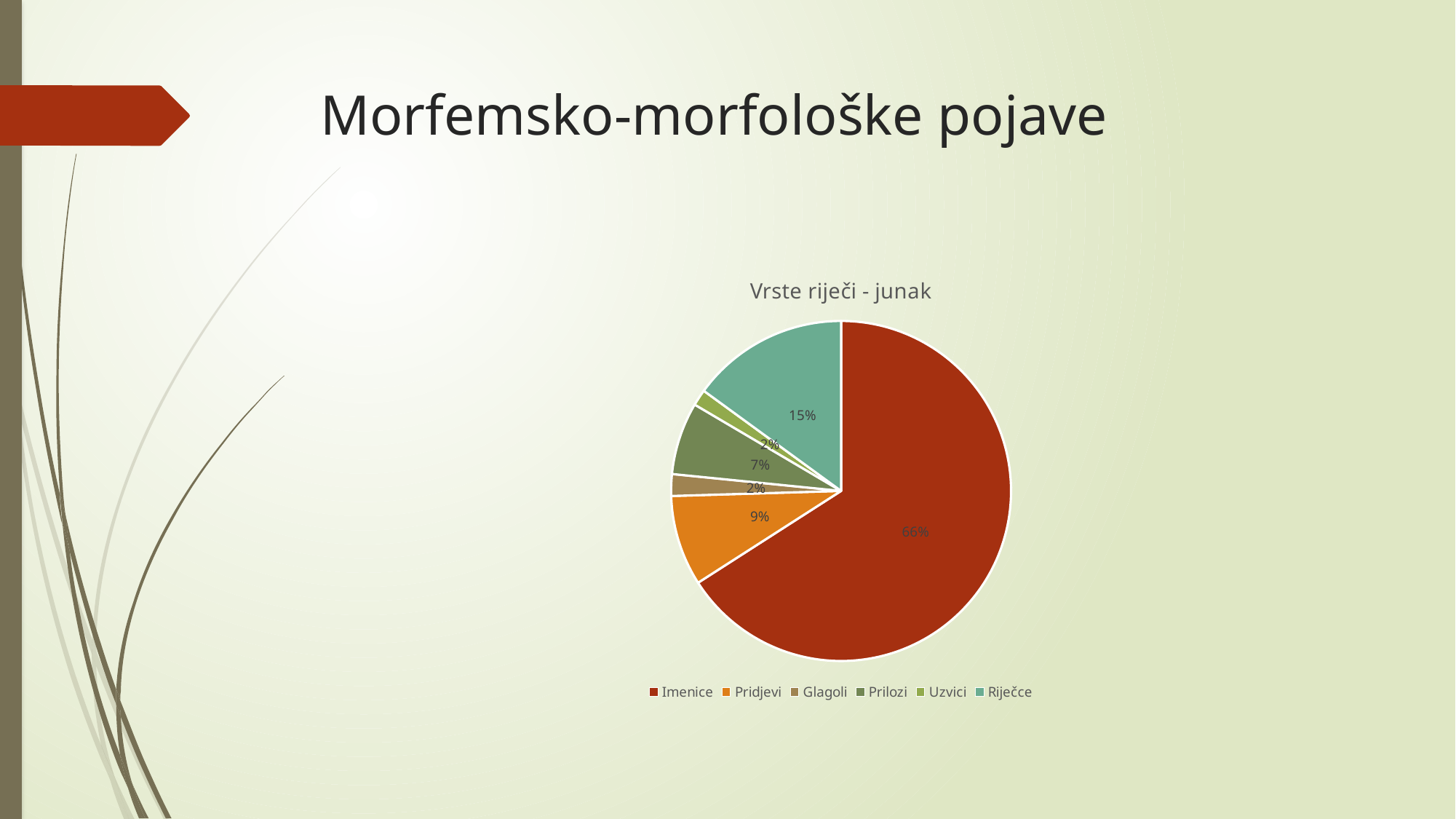
What share of the pie does Riječce take? 15% What is the title of the chart? Vrste riječi - junak Which is larger, the slice for Riječce or the slice for Pridjevi? Riječce What share of the pie does Imenice take? 66% What share of the pie does Prilozi take? 7% What kind of chart is shown on the slide? pie chart Which category is shown in orange in the legend? Pridjevi Which category has the largest slice of the pie? Imenice What is the difference in percentage points between the Imenice slice and the Riječce slice? 51 How many categories does the legend list? 6